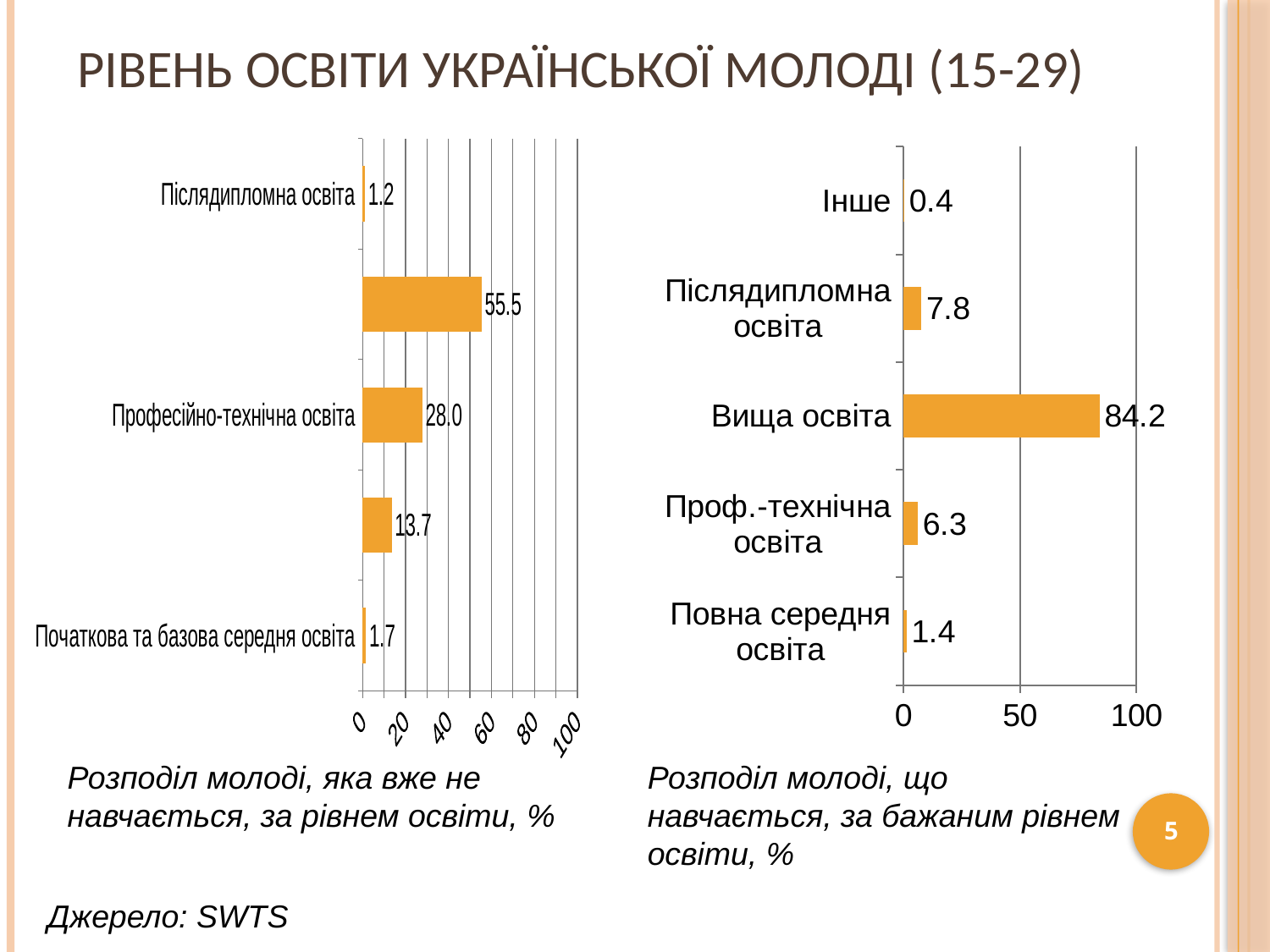
What type of chart is the right chart (youth still studying, desired level)? Bar chart In the right chart (youth still studying, desired level), which category has the highest value? Вища освіта In the right chart (youth still studying, desired level), what is the difference between Післядипломна освіта and Проф.-технічна освіта? 1.5 In the right chart (youth still studying, desired level), what is the value for Вища освіта? 84.2 In the left chart (youth no longer studying), what is the value for Професійно-технічна освіта? 28.0 In the left chart (youth no longer studying), how many bars are plotted? 5 In the right chart (youth still studying, desired level), which category has the lowest value? Інше In the right chart (youth still studying, desired level), which is larger: Повна середня освіта or Проф.-технічна освіта? Проф.-технічна освіта In the right chart (youth still studying, desired level), what is the value for Післядипломна освіта? 7.8 In the left chart (youth no longer studying), what is the value for Післядипломна освіта? 1.2 In the left chart (youth no longer studying), what is the largest value shown on any bar? 55.5 In the left chart (youth no longer studying), what is the value for Початкова та базова середня освіта? 1.7